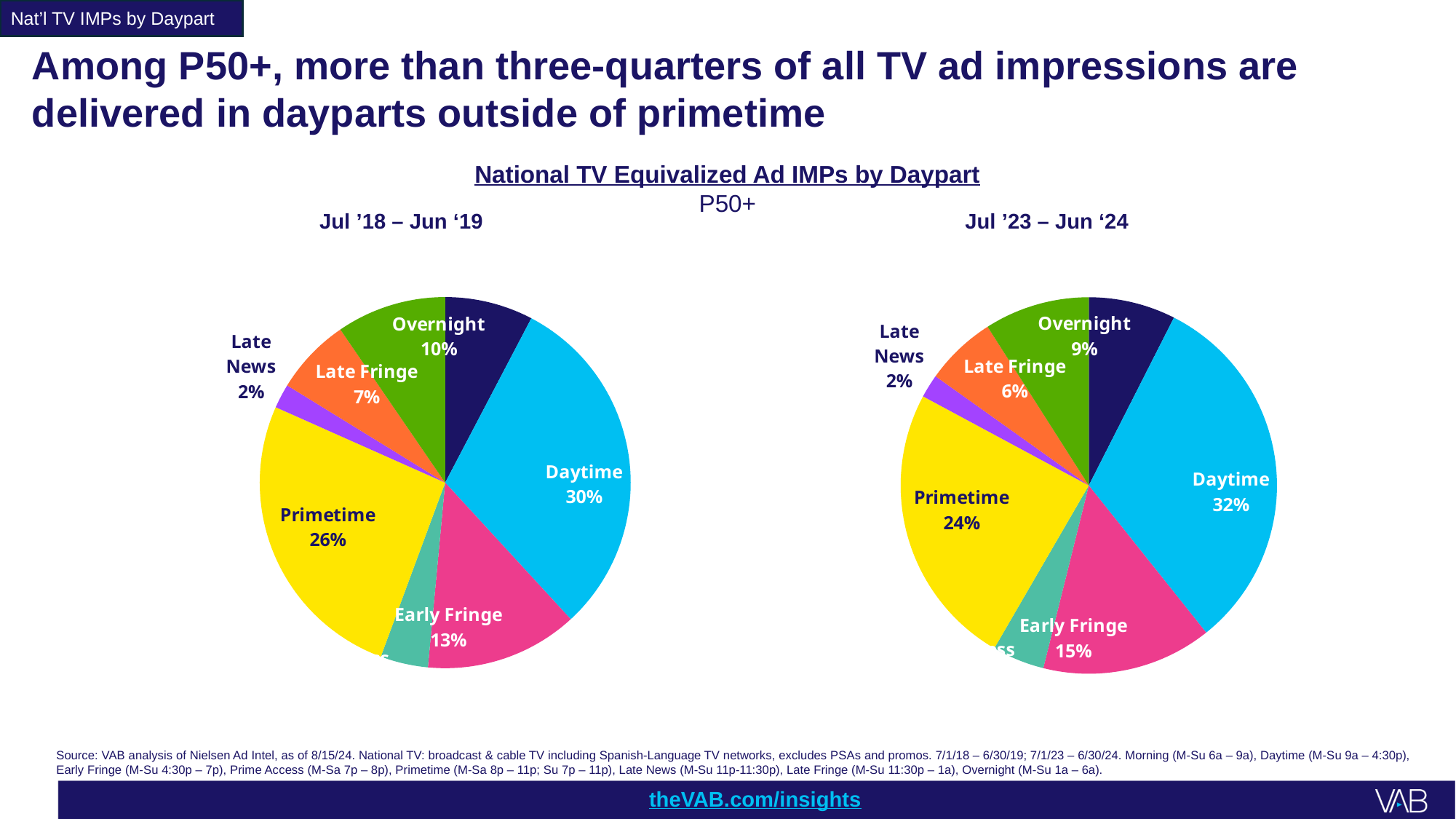
In the Jul '18 – Jun '19 pie chart, what is the value for Early Fringe? 13% In the Jul '23 – Jun '24 pie chart, what is the value for Late Fringe? 6% In the Jul '23 – Jun '24 pie chart, which daypart has the largest share? Daytime In the Jul '23 – Jun '24 pie chart, which is larger, Daytime or Primetime? Daytime In the Jul '18 – Jun '19 pie chart, what is the difference between the Primetime and Early Fringe shares? 13 percentage points In the Jul '23 – Jun '24 pie chart, what share of ad impressions does Primetime account for? 24% In the Jul '18 – Jun '19 pie chart, what share of ad impressions does Daytime account for? 30% In the Jul '23 – Jun '24 pie chart, what is the value for Overnight? 9% How many slices does the Jul '18 – Jun '19 pie chart have? 8 What type of chart is used on this slide? Pie chart In the Jul '18 – Jun '19 pie chart, which daypart has the largest share? Daytime How many percentage points higher is Daytime in the Jul '23 – Jun '24 chart than in the Jul '18 – Jun '19 chart? 2 percentage points